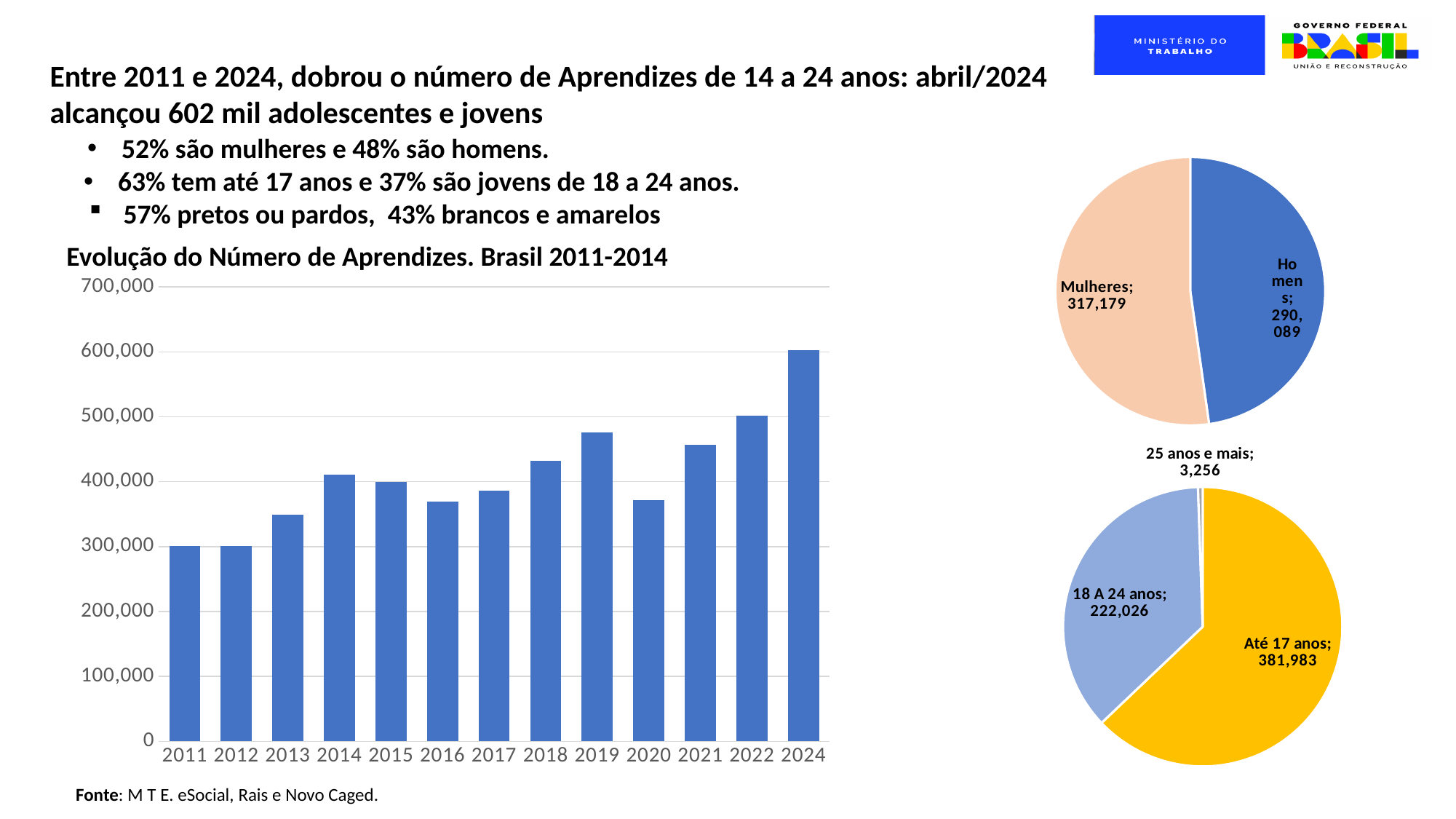
What kind of chart is 'Evolução do Número de Aprendizes. Brasil 2011-2014'? bar chart In the bar chart 'Evolução do Número de Aprendizes. Brasil 2011-2014', is the value for 2022 larger than the value for 2020? Yes In the bar chart 'Evolução do Número de Aprendizes. Brasil 2011-2014', is the value for 2021 greater or less than 400,000? greater In the bar chart 'Evolução do Número de Aprendizes. Brasil 2011-2014', which year has the highest value? 2024 In the bar chart 'Evolução do Número de Aprendizes. Brasil 2011-2014', is the value for 2019 greater or less than 500,000? less In the top-right pie chart (gender), what is the value for Mulheres? 317,179 In the bottom-right pie chart (age groups), what is the value for 'Até 17 anos'? 381,983 In the bar chart 'Evolução do Número de Aprendizes. Brasil 2011-2014', is the value for 2020 greater or less than 400,000? less In the bar chart 'Evolução do Número de Aprendizes. Brasil 2011-2014', how many years are shown on the x axis? 13 In the top-right pie chart (gender), what is the value for Homens? 290,089 In the bottom-right pie chart (age groups), which category has the smallest value? 25 anos e mais In the top-right pie chart (gender), what is the difference between Mulheres and Homens? 27,090